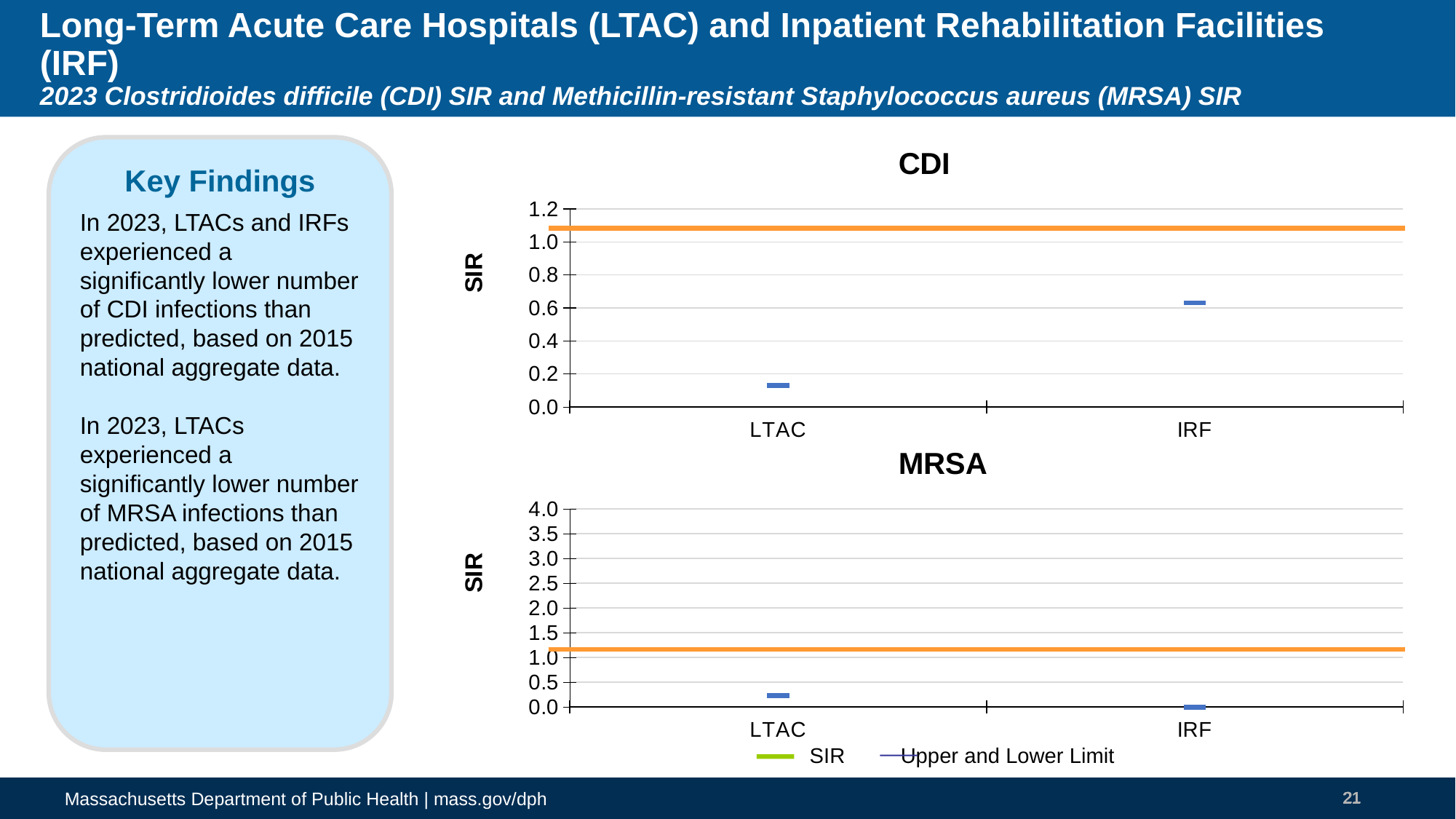
In the CDI chart, is the orange horizontal line greater or less than 1.0? greater How many series does the legend at the bottom of the slide list? 2 In the MRSA chart, which category has the higher value, LTAC or IRF? LTAC In the CDI chart, which category has the higher value, LTAC or IRF? IRF In the MRSA chart, is the value for LTAC greater or less than 0.5? less In the CDI chart, is the value for LTAC greater or less than 0.2? less How many categories are shown on the x axis of the CDI chart? 2 What is the y-axis label on the MRSA chart? SIR